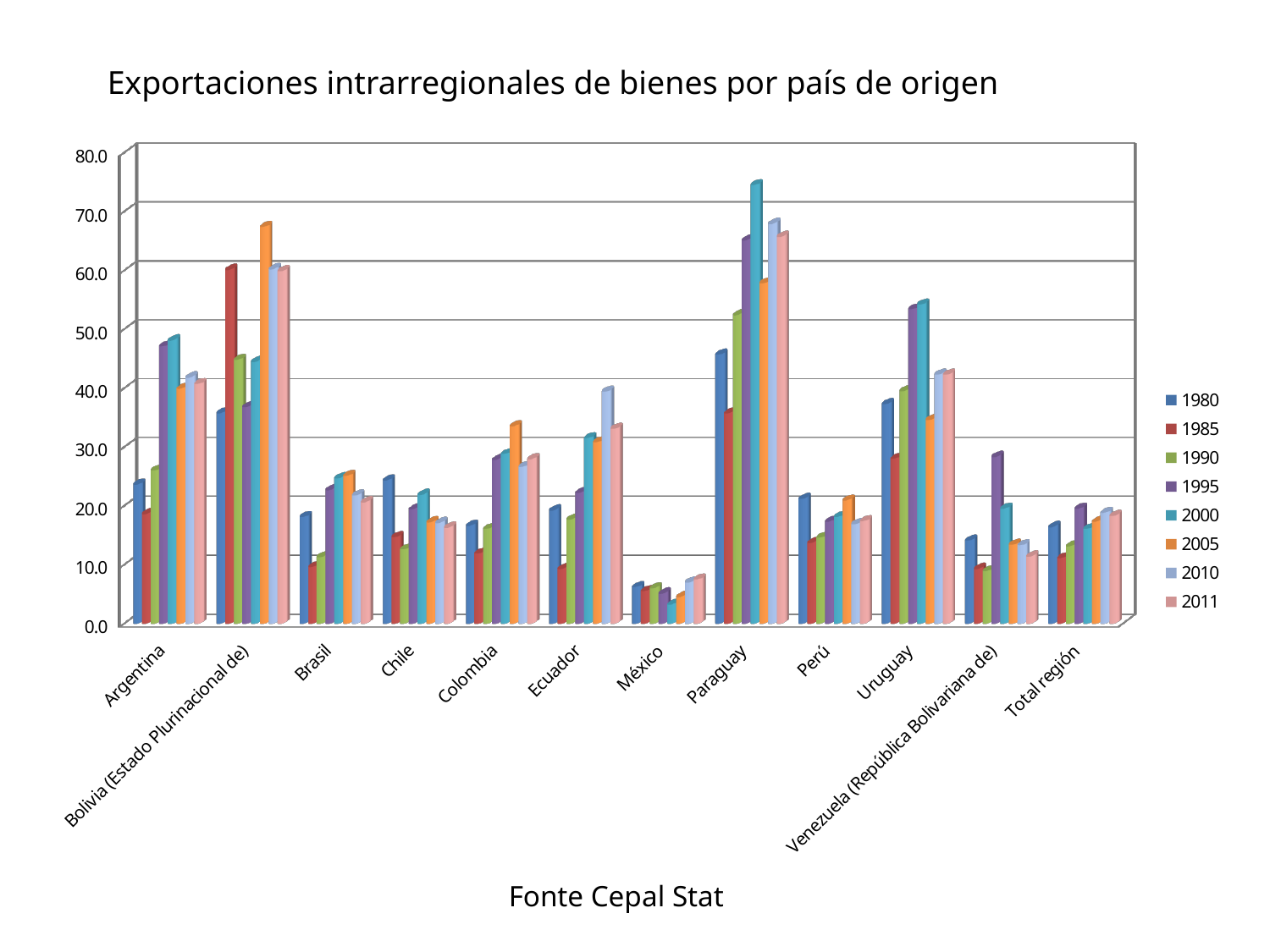
Is the value for Bolivia (Estado Plurinacional de) in 2005 greater or less than 60? greater Which country has the lowest bar for the year 1980? México What kind of chart is shown on the slide? bar chart How many countries/categories are shown on the x axis of the chart? 12 Which country has the highest bar for the year 2000? Paraguay Is the value for Uruguay in 1995 greater or less than 50? greater What is the title of the chart? Exportaciones intrarregionales de bienes por país de origen Is the value for Paraguay in 2000 greater or less than 70? greater How many series (years) does the legend list? 8 Which is larger for Chile: the value in 1980 or the value in 1985? 1980 Which is larger for Ecuador: the value in 2010 or the value in 1980? 2010